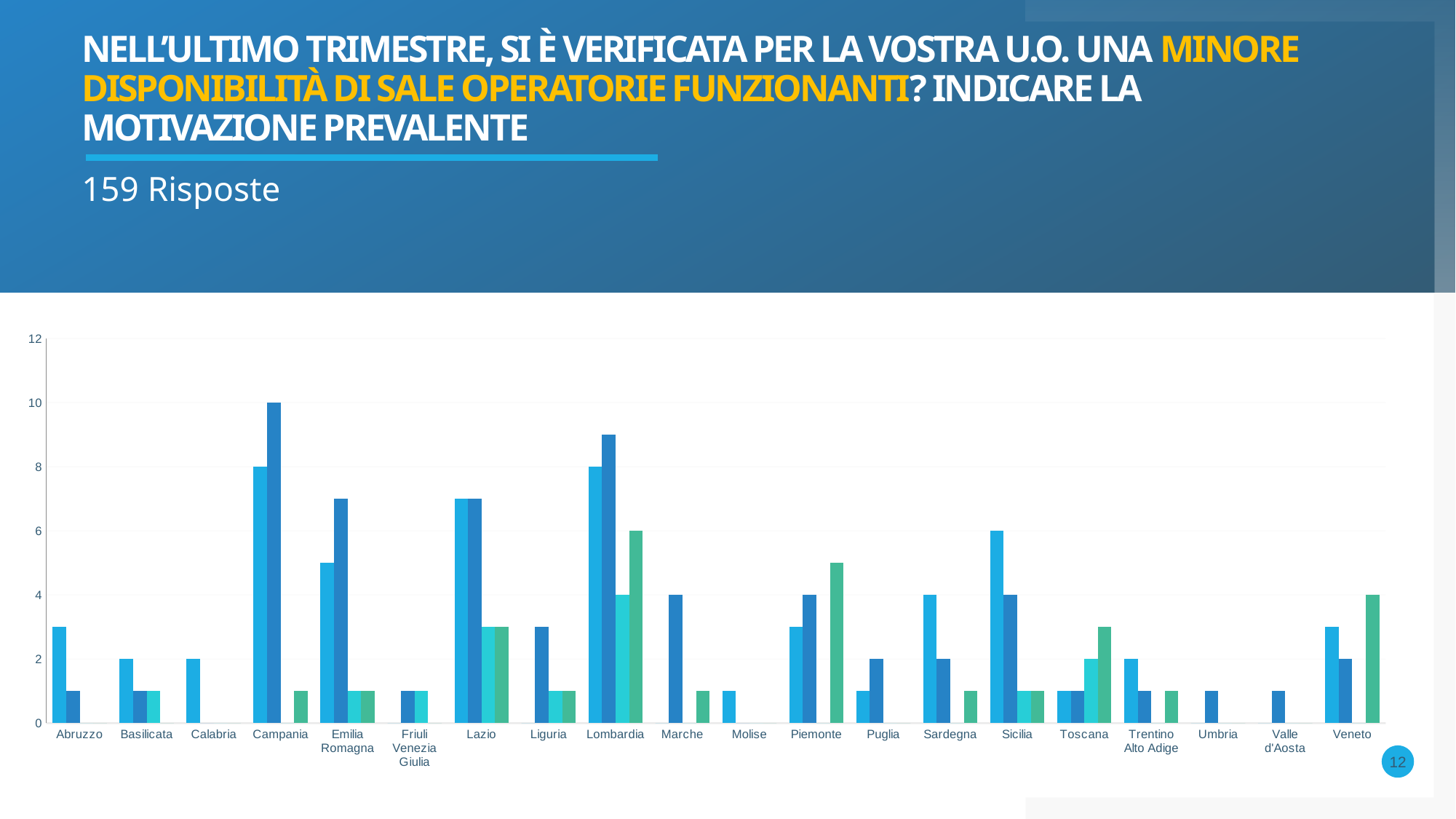
How many regions are listed along the x axis of the chart? 20 Which region has the tallest bar in the chart? Campania What is the value of the light blue bar for Sicilia? 6 Which is larger: the dark blue bar for Campania or the dark blue bar for Lombardia? Campania What is the difference between the dark blue bar and the light blue bar for Campania? 2 What is the value of the dark blue bar for Campania? 10 Is the value of the light blue bar for Lazio greater or less than 6? greater What is the value of the light blue bar for Lombardia? 8 What is the value of the green bar for Veneto? 4 What is the highest value shown on the y axis of the chart? 12 Is the value of the dark blue bar for Lombardia greater or less than 8? greater What kind of chart is shown on the slide? bar chart